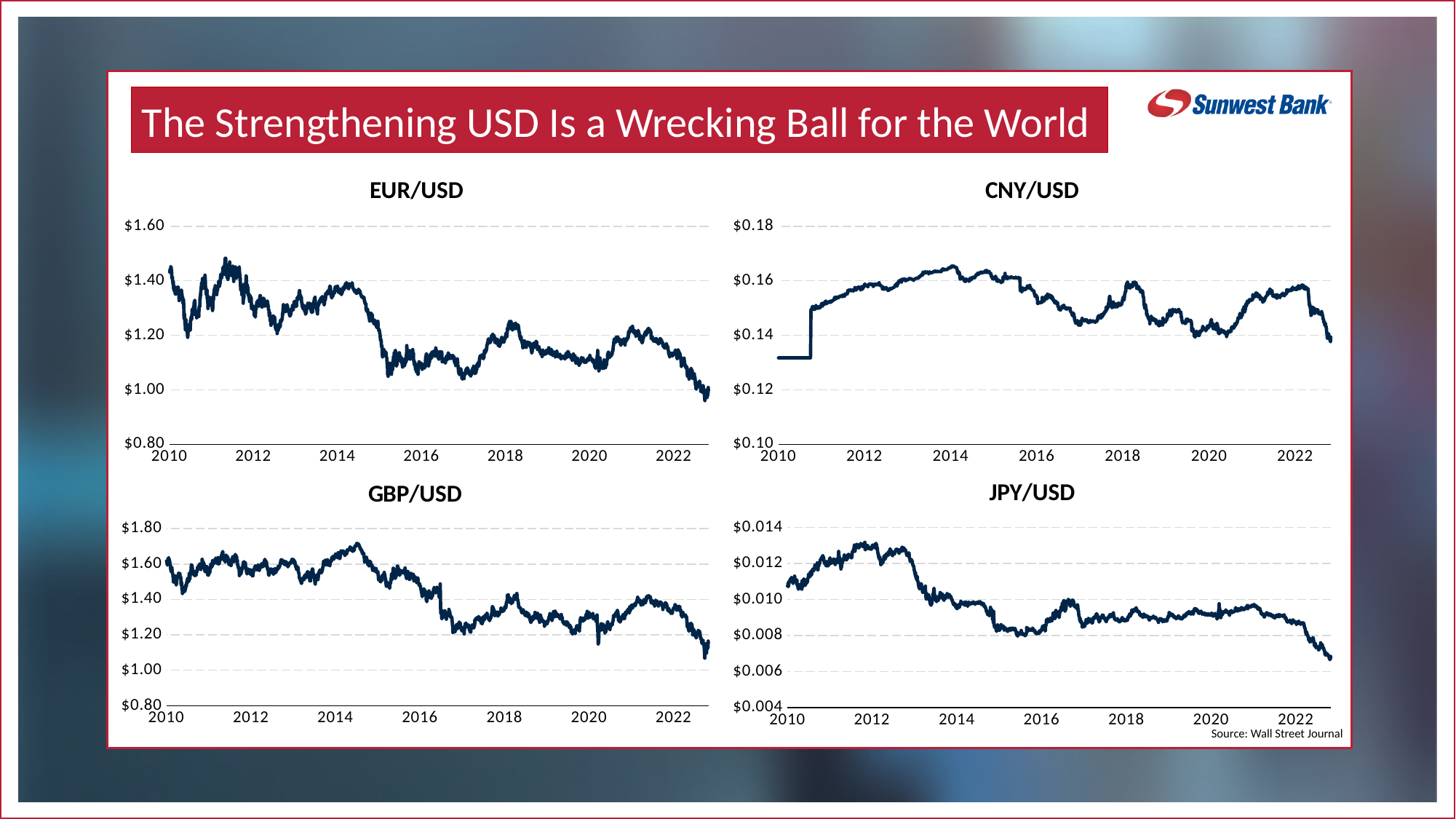
In the GBP/USD chart, is the value at the start of 2010 greater or less than $1.40? greater In the CNY/USD chart, does the value rise or fall from 2010 to 2014? rise In the EUR/USD chart, is the value at the start of 2010 greater or less than $1.20? greater In the JPY/USD chart, does the value rise or fall from 2020 to 2022? fall How many charts are shown on the slide? 4 What is the title of the slide containing the four currency charts? The Strengthening USD Is a Wrecking Ball for the World In the CNY/USD chart, is the value at the start of 2010 greater or less than $0.14? less In the EUR/USD chart, does the value overall rise or fall from 2010 to 2022? fall What kind of chart is the EUR/USD chart? line chart What source is cited for the charts on the slide? Wall Street Journal